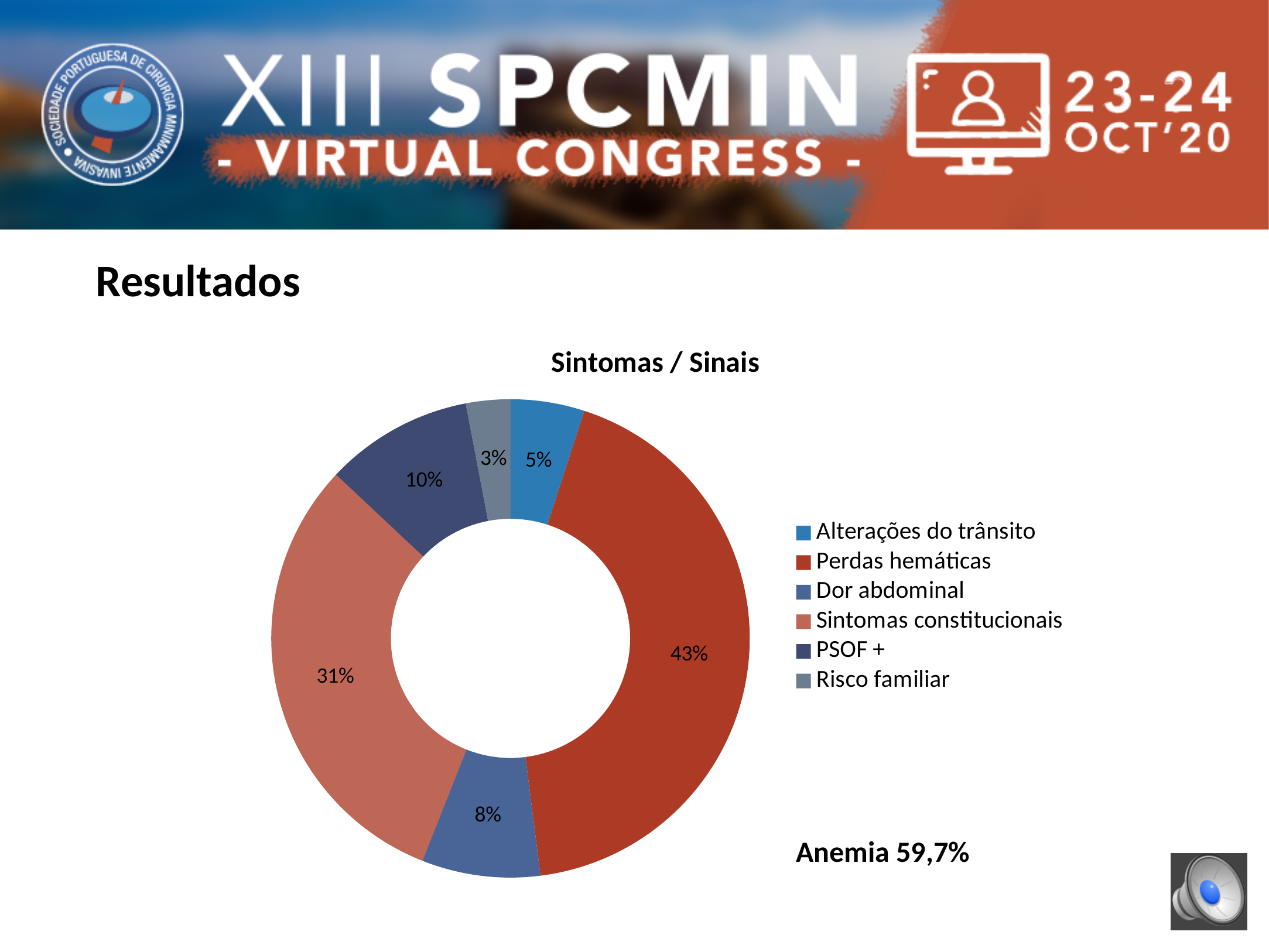
Which is larger, the share for PSOF + or the share for Alterações do trânsito? PSOF + What share of the chart does Perdas hemáticas represent? 43% Which category has the largest share of the chart? Perdas hemáticas What share of the chart does Sintomas constitucionais represent? 31% What is the title of the chart? Sintomas / Sinais Which category has the smallest share of the chart? Risco familiar What kind of chart is shown on the slide? Doughnut (pie) chart What is the value shown for Risco familiar? 3% What is the value shown for Dor abdominal? 8% How many categories does the legend list? 6 What is the difference between the shares of Perdas hemáticas and Sintomas constitucionais? 12 percentage points What is the value shown for PSOF +? 10%